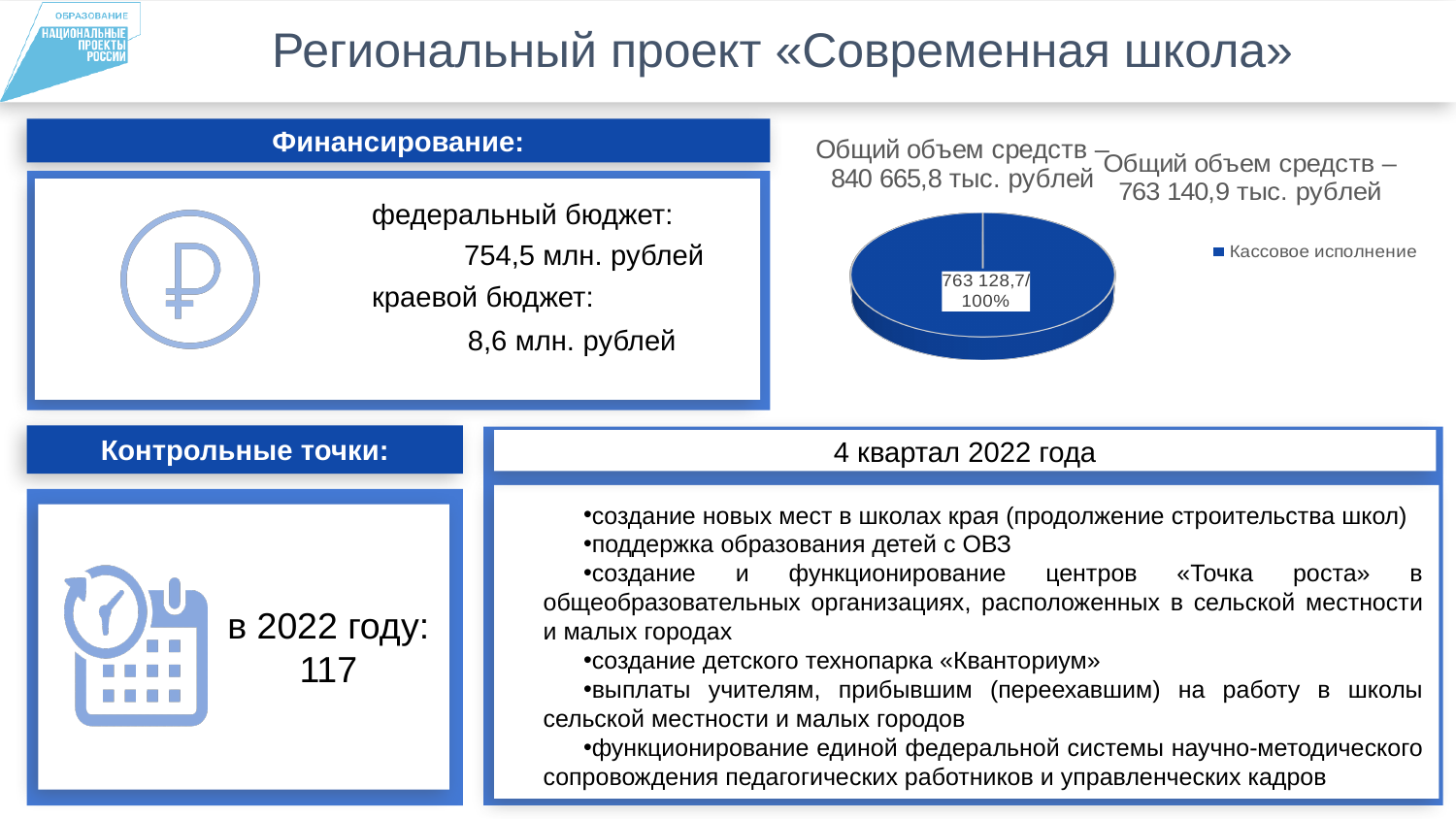
What share of the pie does the "Кассовое исполнение" slice represent? 100% What kind of chart is shown on the slide? pie chart What value is printed on the slice of the pie chart? 763 128,7 What colour is the slice of the pie chart? blue How many entries does the legend of the pie chart list? 1 How many slices does the pie chart have? 1 What is the name of the series listed in the pie chart's legend? Кассовое исполнение